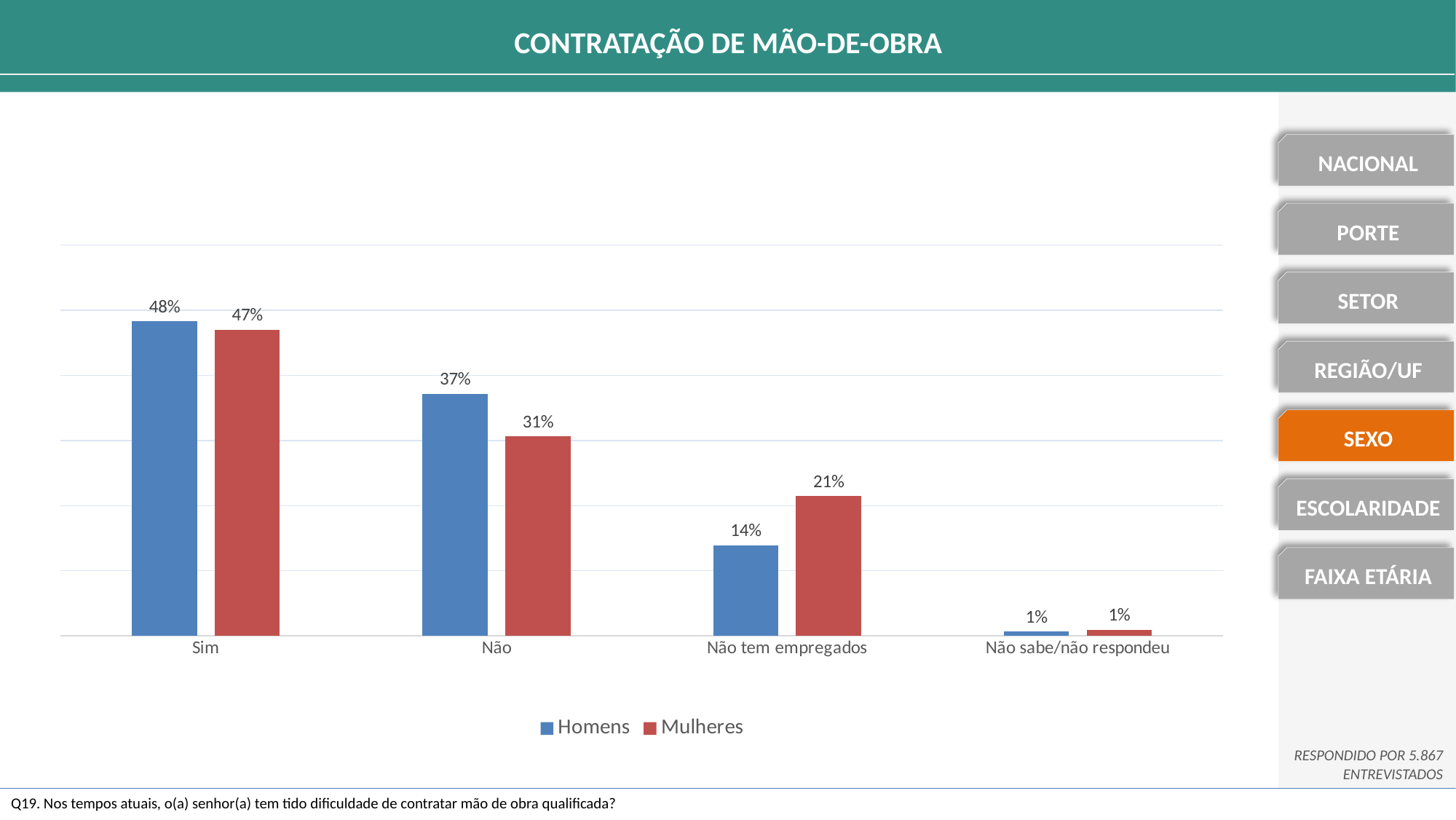
Which series is shown in red in the legend? Mulheres What is the value for Mulheres in the Não tem empregados category? 21% What is the difference between Mulheres and Homens in the Não tem empregados category? 7% What is the value for Mulheres in the Não category? 31% How many categories are shown on the x axis? 4 Which category has the lowest value for Mulheres? Não sabe/não respondeu Which category has the highest value for Homens? Sim Which is larger in the Não tem empregados category, Homens or Mulheres? Mulheres What is the difference between Homens and Mulheres in the Não category? 6% How many series does the legend list? 2 What is the value for Homens in the Sim category? 48% What kind of chart is shown on the slide? Bar chart